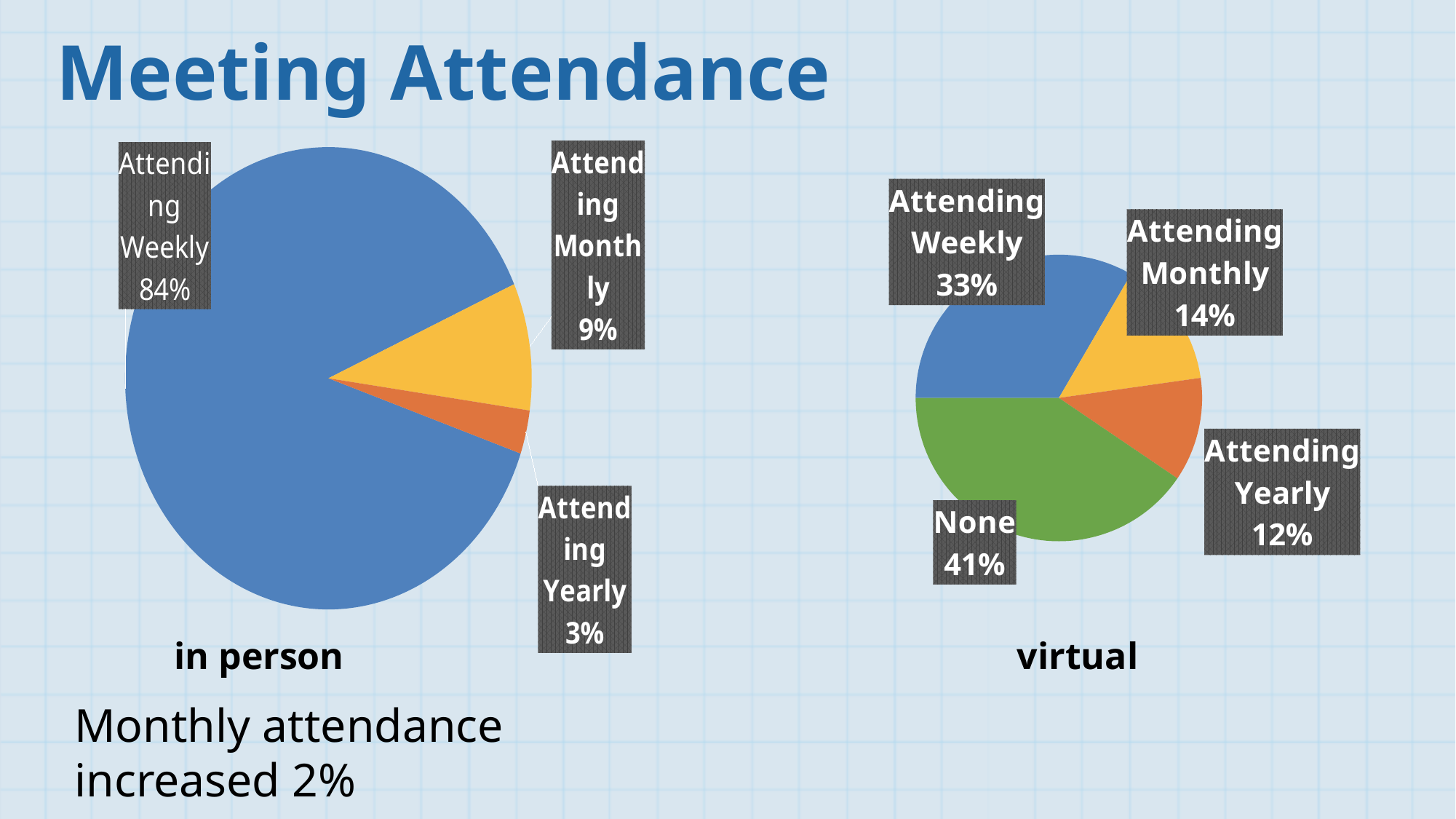
In the 'in person' pie chart, what share is labelled for Attending Yearly? 3% In the 'virtual' pie chart, what is the difference in percentage points between None and Attending Weekly? 8 In the 'virtual' pie chart, which category has the largest slice? None What type of chart is used for the 'in person' data? Pie chart In the 'virtual' pie chart, what share is labelled for None? 41% In the 'virtual' pie chart, what share is labelled for Attending Monthly? 14% Which is larger: Attending Weekly in the 'in person' chart or Attending Weekly in the 'virtual' chart? in person In the 'virtual' pie chart, which category has the smallest slice? Attending Yearly In the 'in person' pie chart, which category has the smallest slice? Attending Yearly In the 'in person' pie chart, what share is labelled for Attending Weekly? 84% How many slices does the 'virtual' pie chart have? 4 In the 'in person' pie chart, what share is labelled for Attending Monthly? 9%